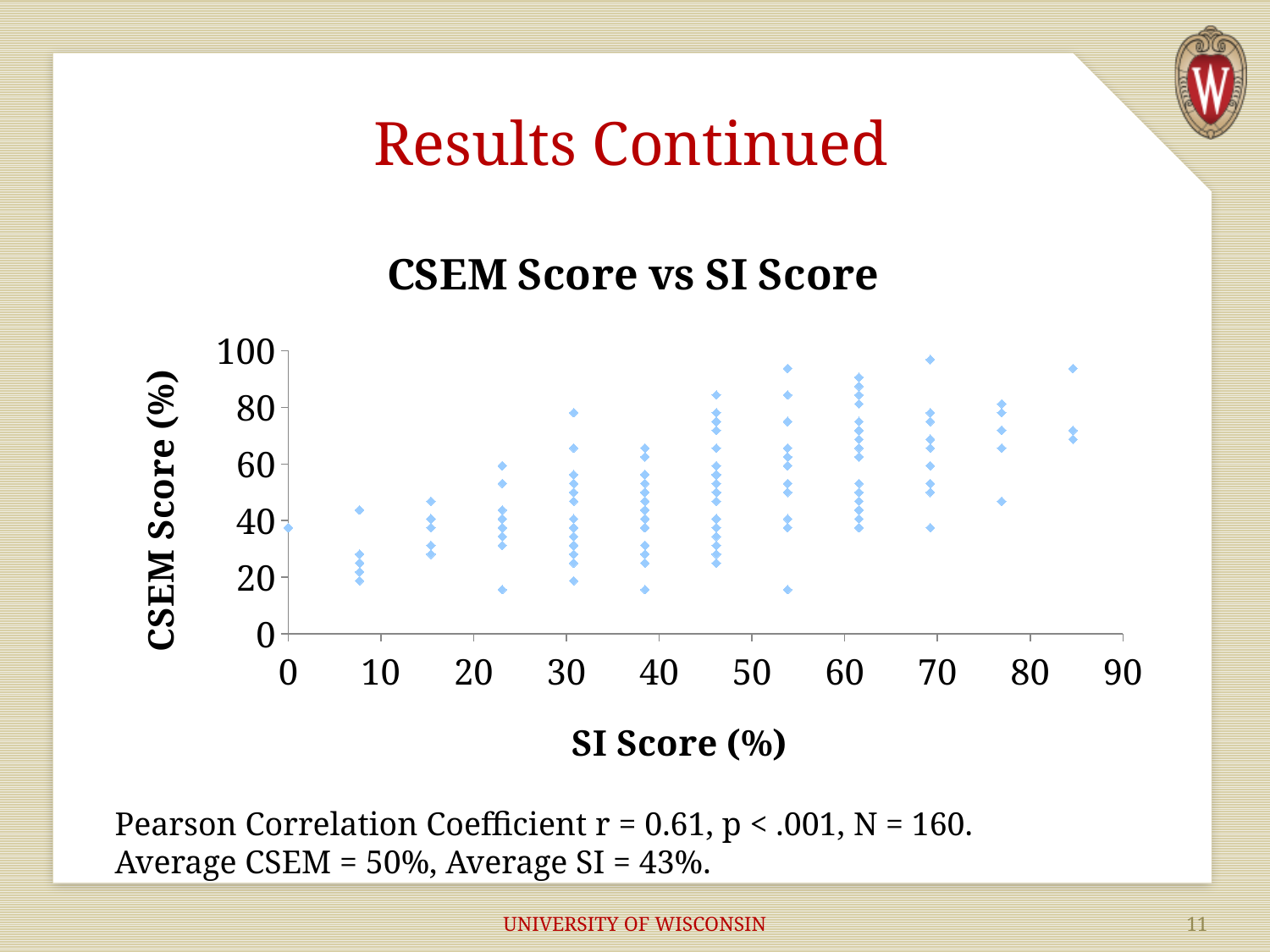
Is the highest CSEM Score among the points at SI Score of about 85 greater or less than 80? greater What kind of chart is shown on the slide? scatter plot Is the highest CSEM Score plotted on the chart greater or less than 80? greater Is the lowest CSEM Score among the points at SI Score of about 8 greater or less than 40? less According to the slide, how many data points (N) are in the chart? 160 Do CSEM scores generally rise or fall as SI Score increases along the x axis? rise What is the label of the x axis of the chart? SI Score (%) What is the title of the chart? CSEM Score vs SI Score